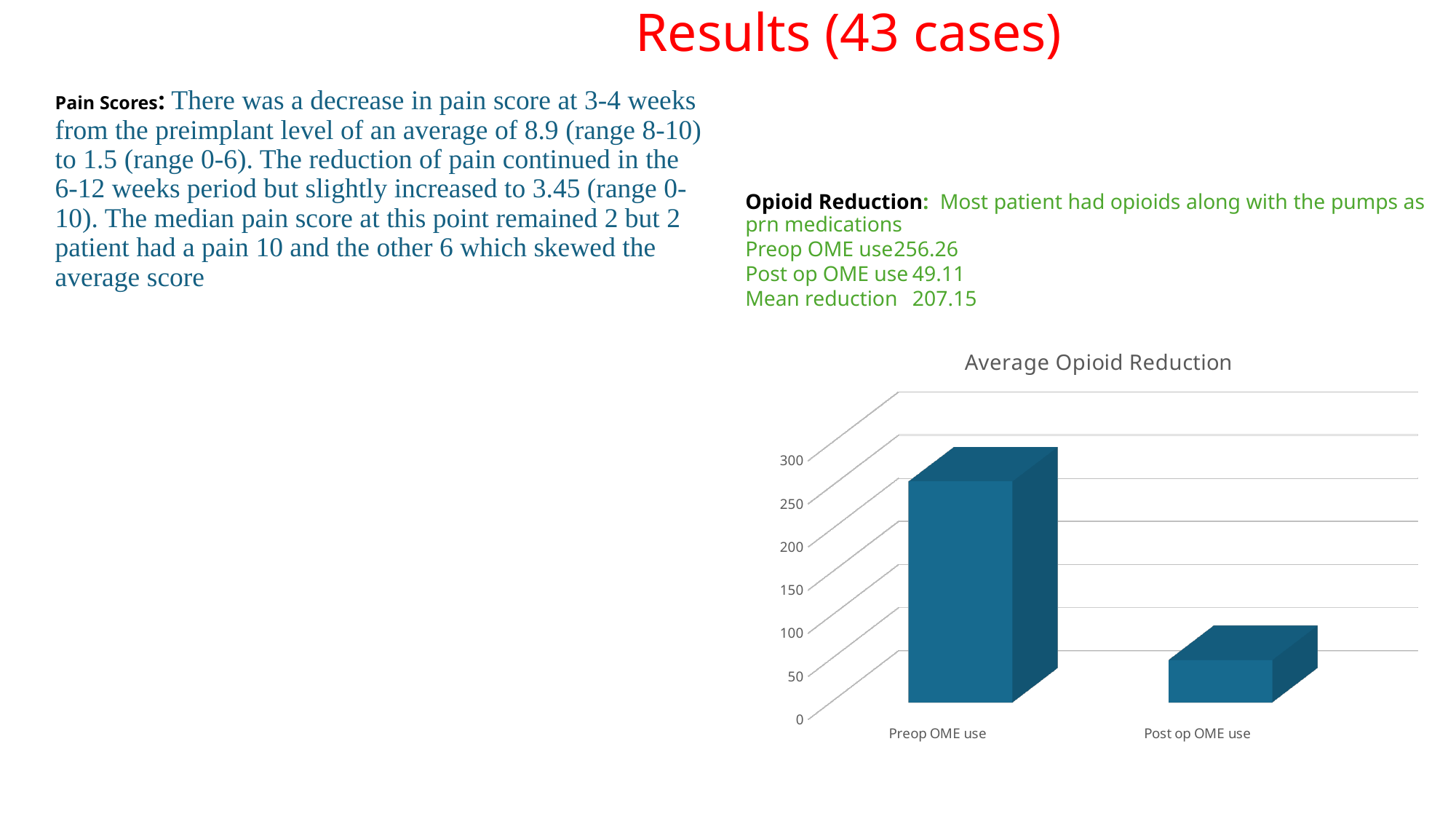
Which is larger in the chart, Preop OME use or Post op OME use? Preop OME use Which category has the lowest bar in the chart? Post op OME use What is the title of the chart? Average Opioid Reduction Is the value for Preop OME use greater or less than 300? less What type of chart is shown on the slide? bar chart Do the values rise or fall from Preop OME use to Post op OME use? fall Is the value for Preop OME use greater or less than 200? greater How many categories are plotted in the chart? 2 Which category has the highest bar in the chart? Preop OME use What is the highest tick value shown on the vertical axis of the chart? 300 Is the value for Post op OME use greater or less than 100? less